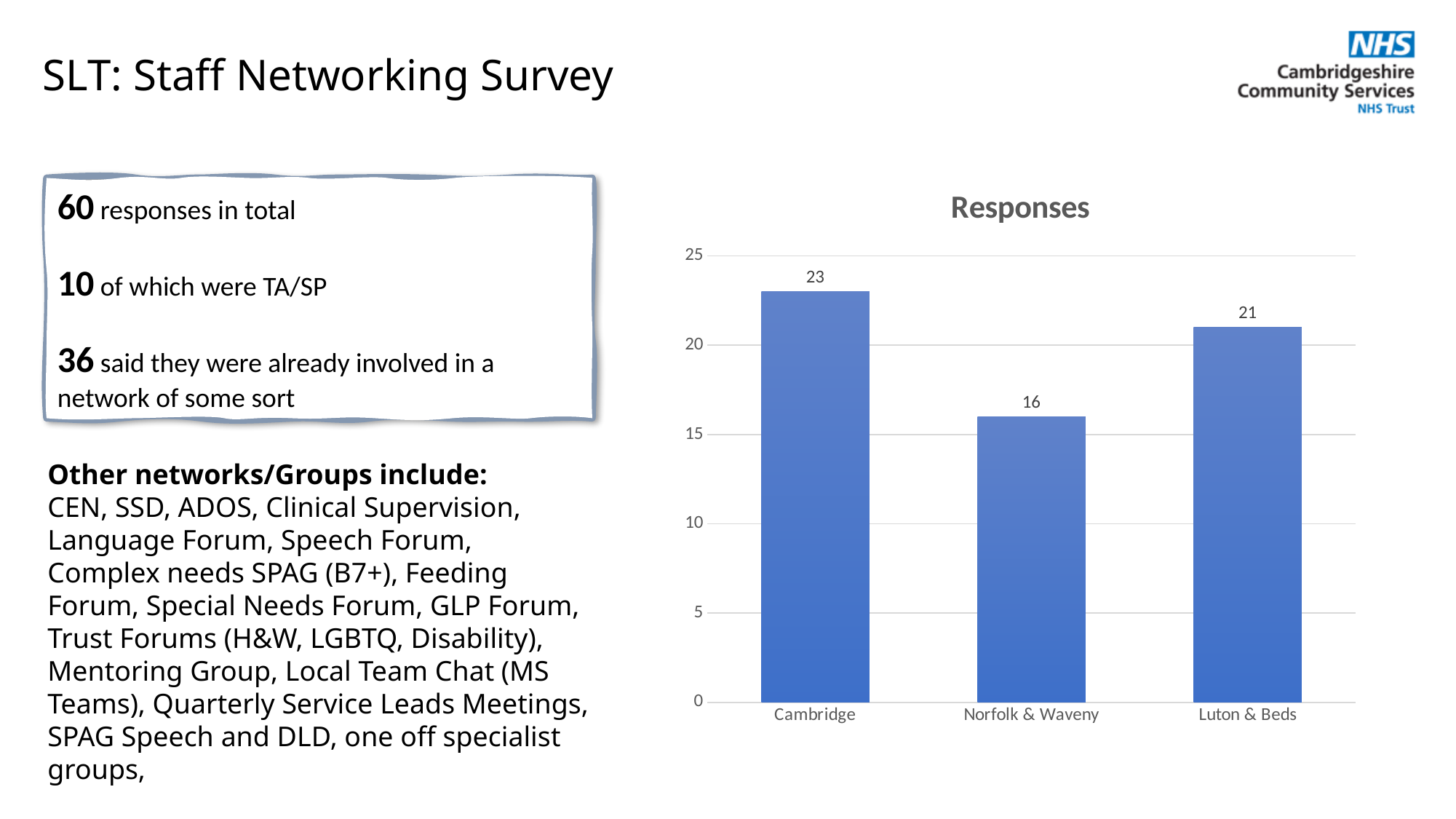
Which category has the highest value in the Responses chart? Cambridge What is the difference between the values for Cambridge and Norfolk & Waveny? 7 What is the value for Luton & Beds in the Responses chart? 21 What is the value for Cambridge in the Responses chart? 23 What is the value for Norfolk & Waveny in the Responses chart? 16 What is the difference between the values for Luton & Beds and Norfolk & Waveny? 5 How many categories are shown in the Responses chart? 3 Which is larger, the value for Cambridge or the value for Luton & Beds? Cambridge Which category has the lowest value in the Responses chart? Norfolk & Waveny What is the title of the chart on the slide? Responses Is the value for Norfolk & Waveny greater or less than 20? less What kind of chart is shown on the slide? bar chart